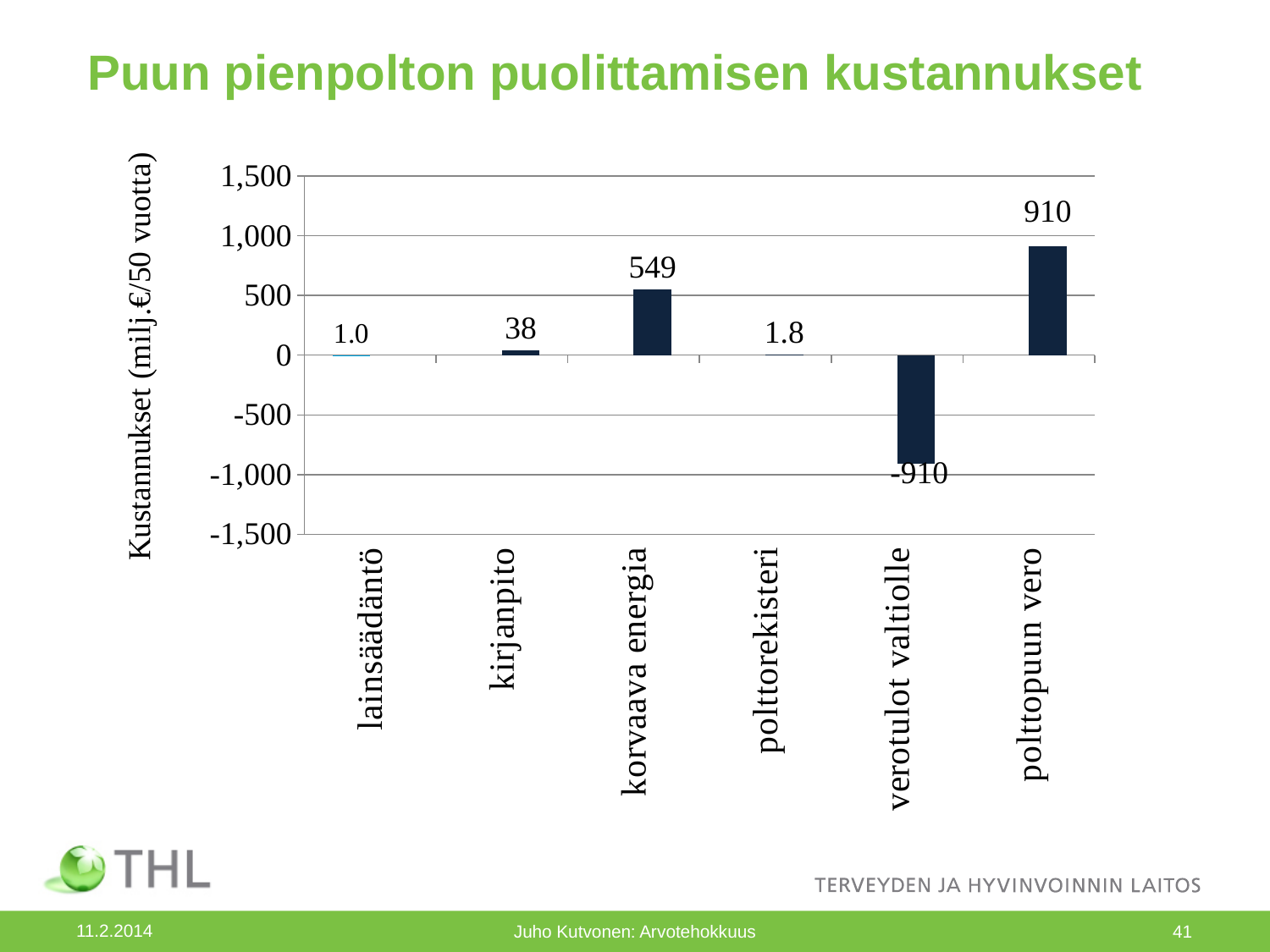
What is the label of the vertical axis? Kustannukset (milj.€/50 vuotta) Which is larger, the value for kirjanpito or the value for polttorekisteri? kirjanpito What is the value for polttopuun vero? 910 What is the difference between the values for polttopuun vero and korvaava energia? 361 What is the value for kirjanpito? 38 What kind of chart is shown on the slide? bar chart What is the value for korvaava energia? 549 How many categories are shown on the x axis? 6 Which category has the lowest value? verotulot valtiolle Which category has the highest value? polttopuun vero What is the value for polttorekisteri? 1.8 What is the value for verotulot valtiolle? -910